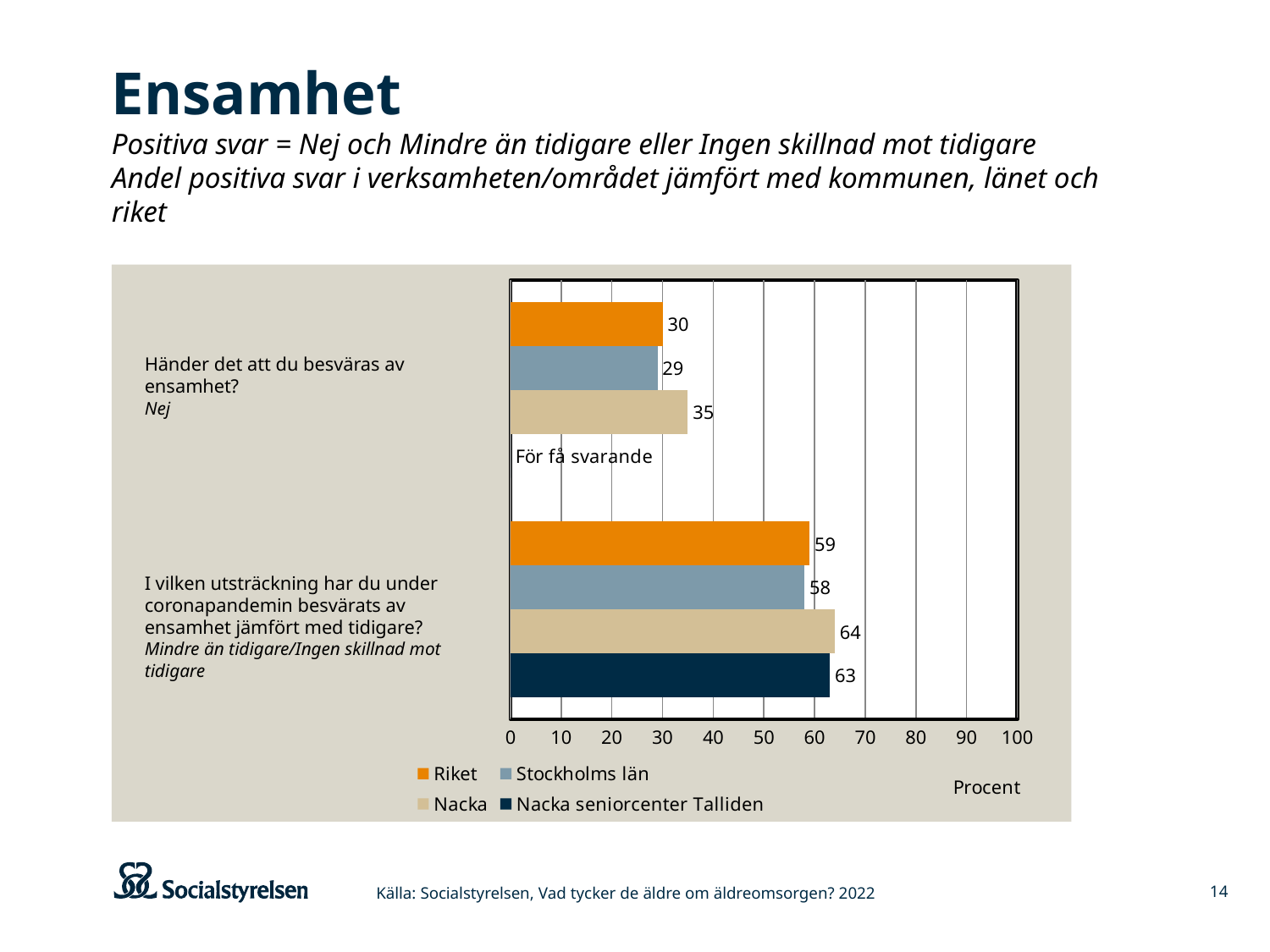
Which series has the highest value on the question about loneliness during the corona pandemic compared to before? Nacka How many series does the legend list? 4 What unit label is shown on the x axis of the chart? Procent What kind of chart is shown on the slide? Bar chart What is the value for Riket on the question "I vilken utsträckning har du under coronapandemin besvärats av ensamhet jämfört med tidigare?"? 59 What is the difference between Nacka and Stockholms län on the question about loneliness during the corona pandemin compared to before? 6 Which is larger on the question about loneliness during the corona pandemic: Nacka or Nacka seniorcenter Talliden? Nacka Which series has the lowest value on the question "Händer det att du besväras av ensamhet?" among those with a plotted bar? Stockholms län What is shown for Nacka seniorcenter Talliden on the question "Händer det att du besväras av ensamhet?"? För få svarande What is the difference between Nacka and Riket on the question "Händer det att du besväras av ensamhet?"? 5 What is the value for Nacka on the question "Händer det att du besväras av ensamhet?"? 35 What is the value for Nacka seniorcenter Talliden on the question about loneliness during the corona pandemic compared to before? 63